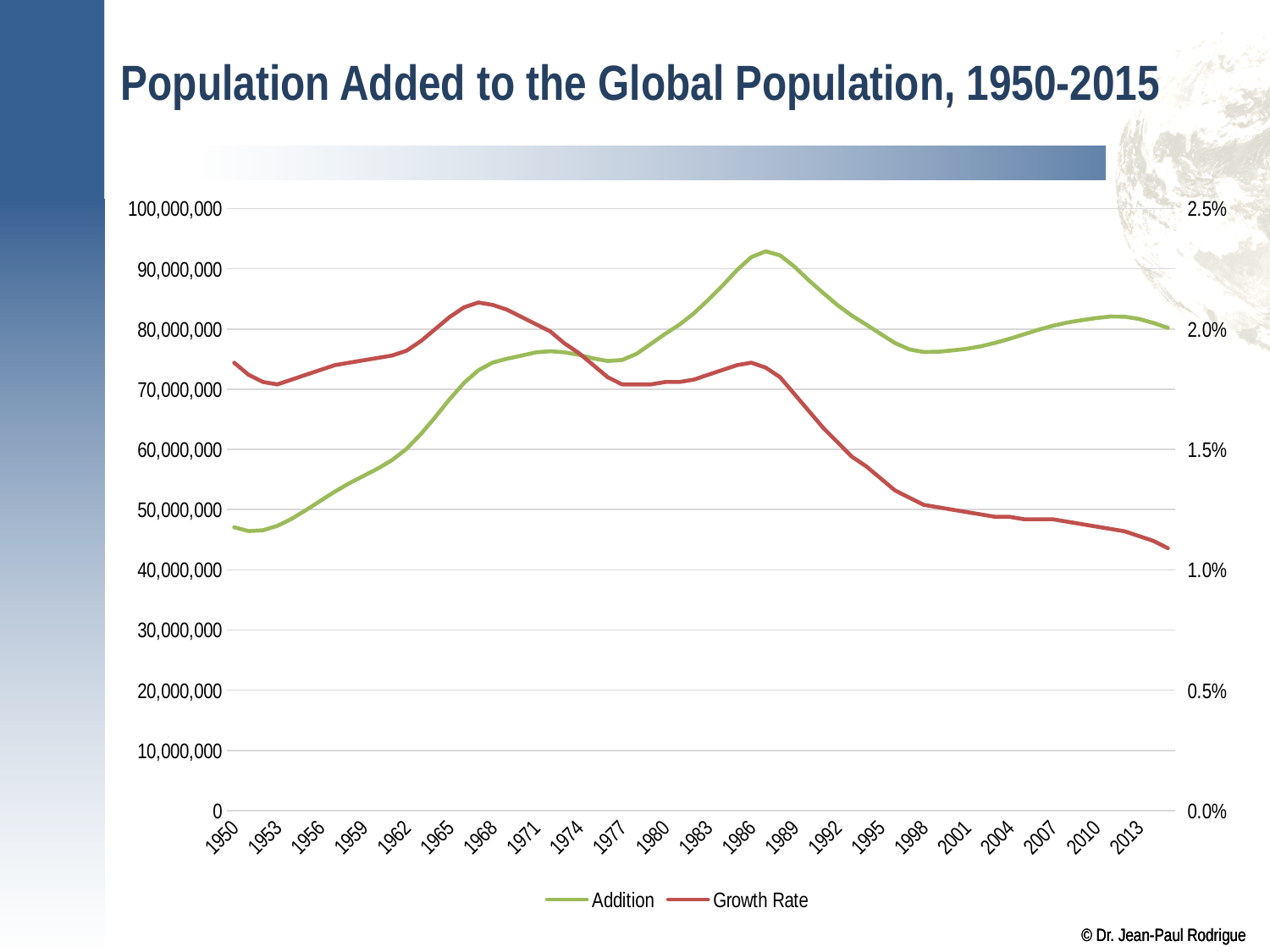
Is the Addition value for 1950 greater or less than 50,000,000? less What kind of chart is shown on the slide? Line chart What colour is the Addition line? Green Is the Growth Rate value for 1995 greater or less than 1.5%? less Is the Addition value for 2013 greater or less than 70,000,000? greater How many year labels are shown on the x axis? 22 What are the two series named in the legend? Addition and Growth Rate Which is larger, the Addition value in 1950 or the Addition value in 2013? 2013 How many series does the legend list? 2 Does the Growth Rate line rise or fall between 1989 and 2013? Fall